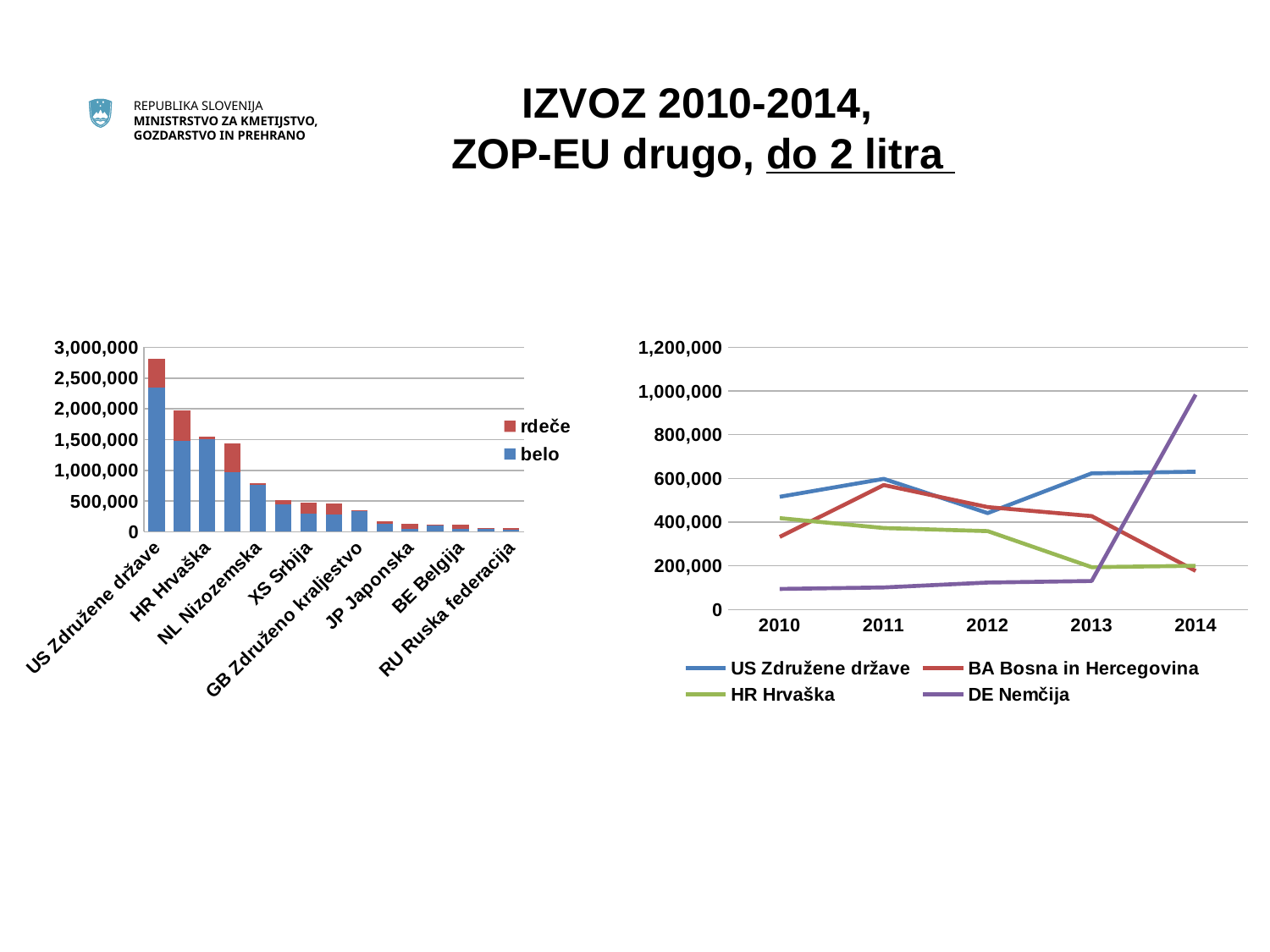
In the right line chart, is the value for DE Nemčija in 2014 greater or less than 800,000? greater What kind of chart is the chart on the right of the slide? line chart What kind of chart is the chart on the left of the slide? bar chart In the right line chart, how many years are shown on the x axis? 5 In the left bar chart, which category has the highest total? US Združene države In the right line chart, how many series does the legend list? 4 In the right line chart, which series has the lowest value in 2010? DE Nemčija In the right line chart, does the value for HR Hrvaška rise or fall from 2010 to 2013? fall In the right line chart, which is larger in 2014: US Združene države or BA Bosna in Hercegovina? US Združene države In the left bar chart, is the total value for US Združene države greater or less than 2,500,000? greater In the right line chart, which series has the highest value in 2014? DE Nemčija In the left bar chart, how many series does the legend list? 2